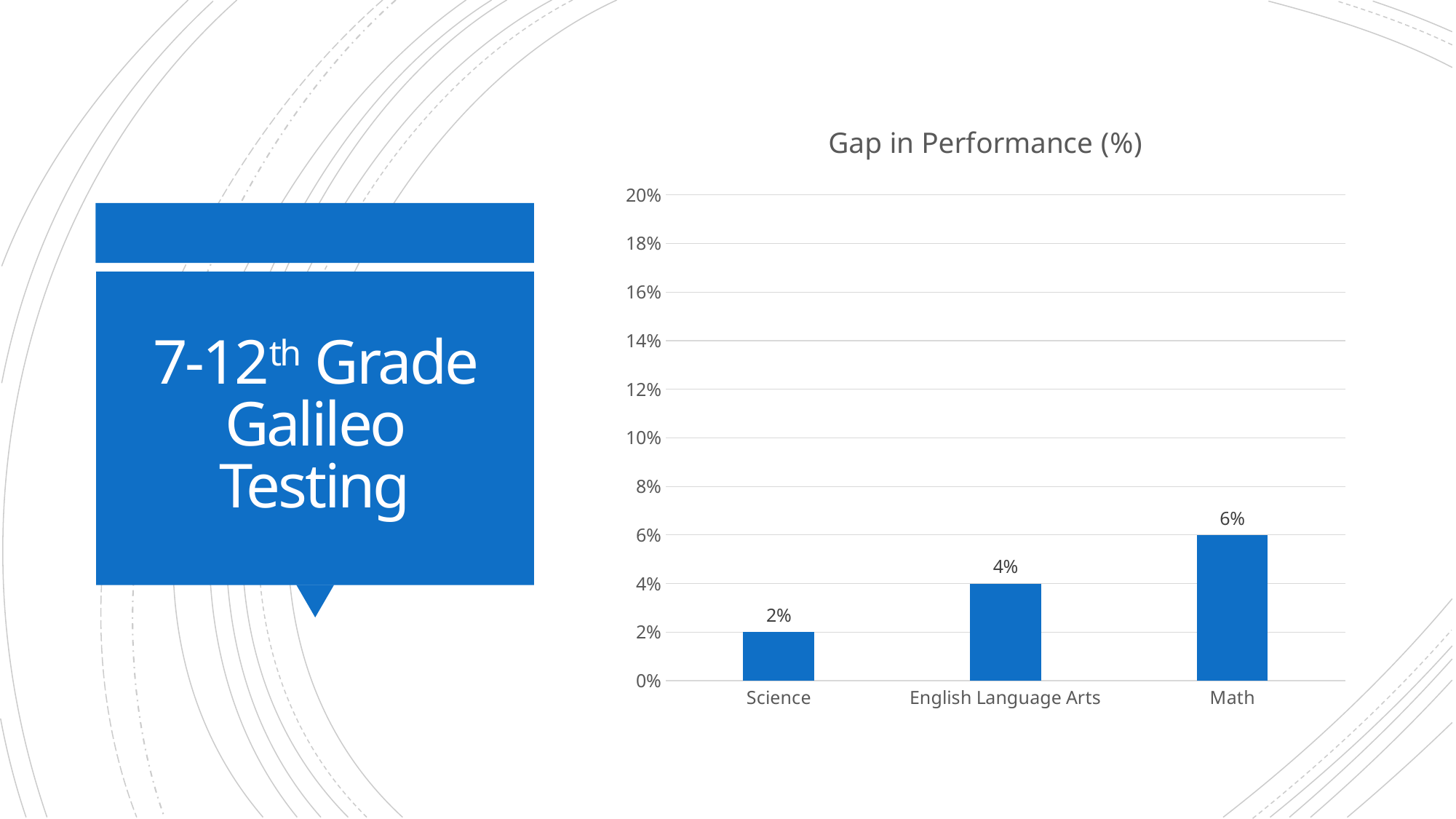
Which subject has the smallest gap in performance? Science What is the gap in performance for English Language Arts? 4% What kind of chart is shown on the slide? Bar chart Which has a larger gap in performance, English Language Arts or Math? Math How many subjects are shown in the chart? 3 What is the gap in performance for Math? 6% What is the title of the chart? Gap in Performance (%) Which subject has the largest gap in performance? Math What is the difference between the gap in performance for Math and for Science? 4% What is the gap in performance for Science? 2% What is the difference between the gap in performance for English Language Arts and for Science? 2% Is the gap in performance for Math greater or less than 10%? less